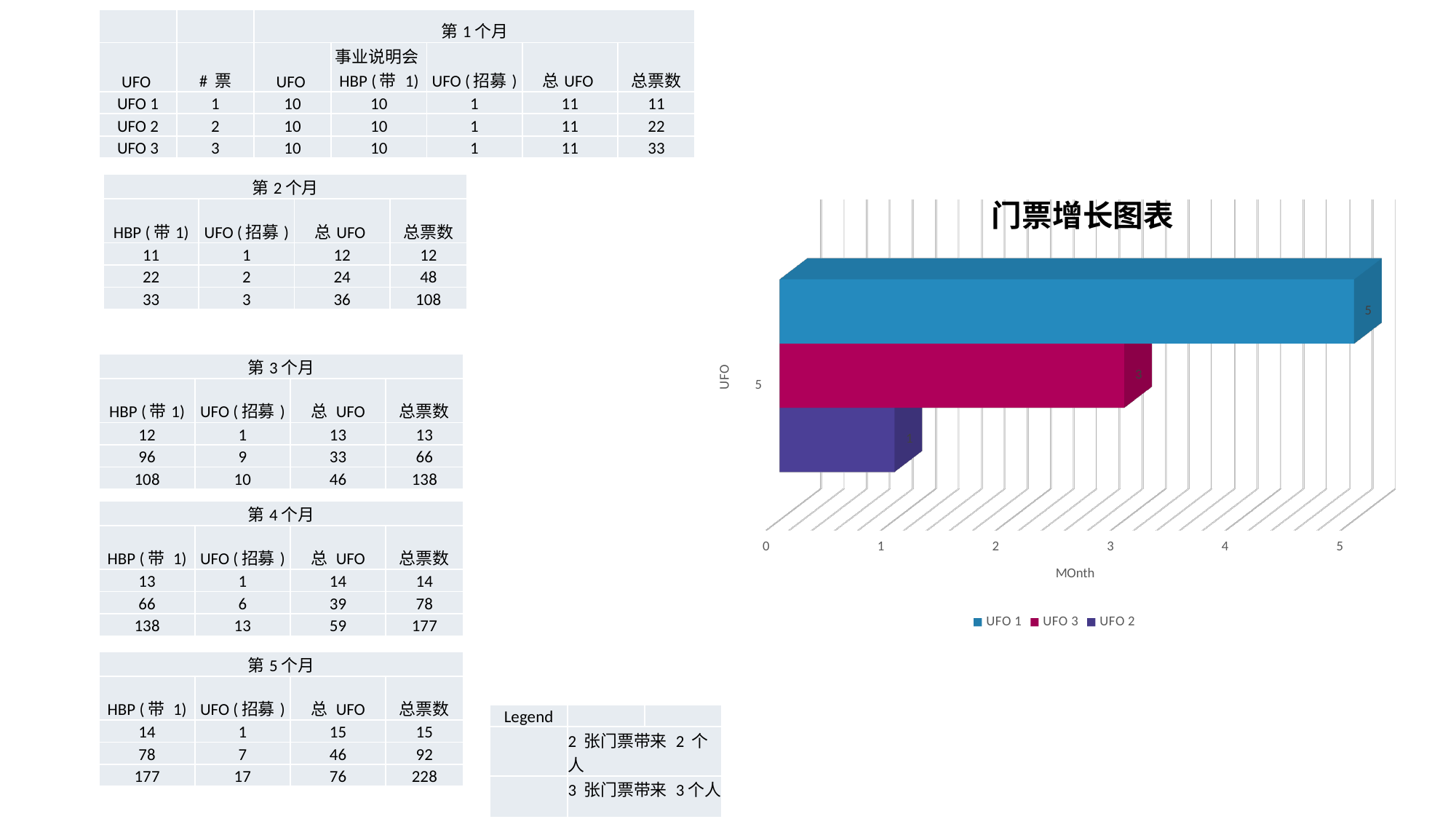
How many series does the chart legend list? 3 Which series has the lowest value in the chart? UFO 2 What type of chart is shown on the slide? bar chart What is the value for UFO 1 in the chart? 5 What is the title of the chart? 门票增长图表 What is the difference between the values for UFO 1 and UFO 3? 2 What is the value for UFO 2 in the chart? 1 What is the label of the horizontal axis of the chart? MOnth Which series has the highest value in the chart? UFO 1 Is the value for UFO 1 greater or less than 4? greater Which is larger, the value for UFO 3 or the value for UFO 2? UFO 3 What is the value for UFO 3 in the chart? 3